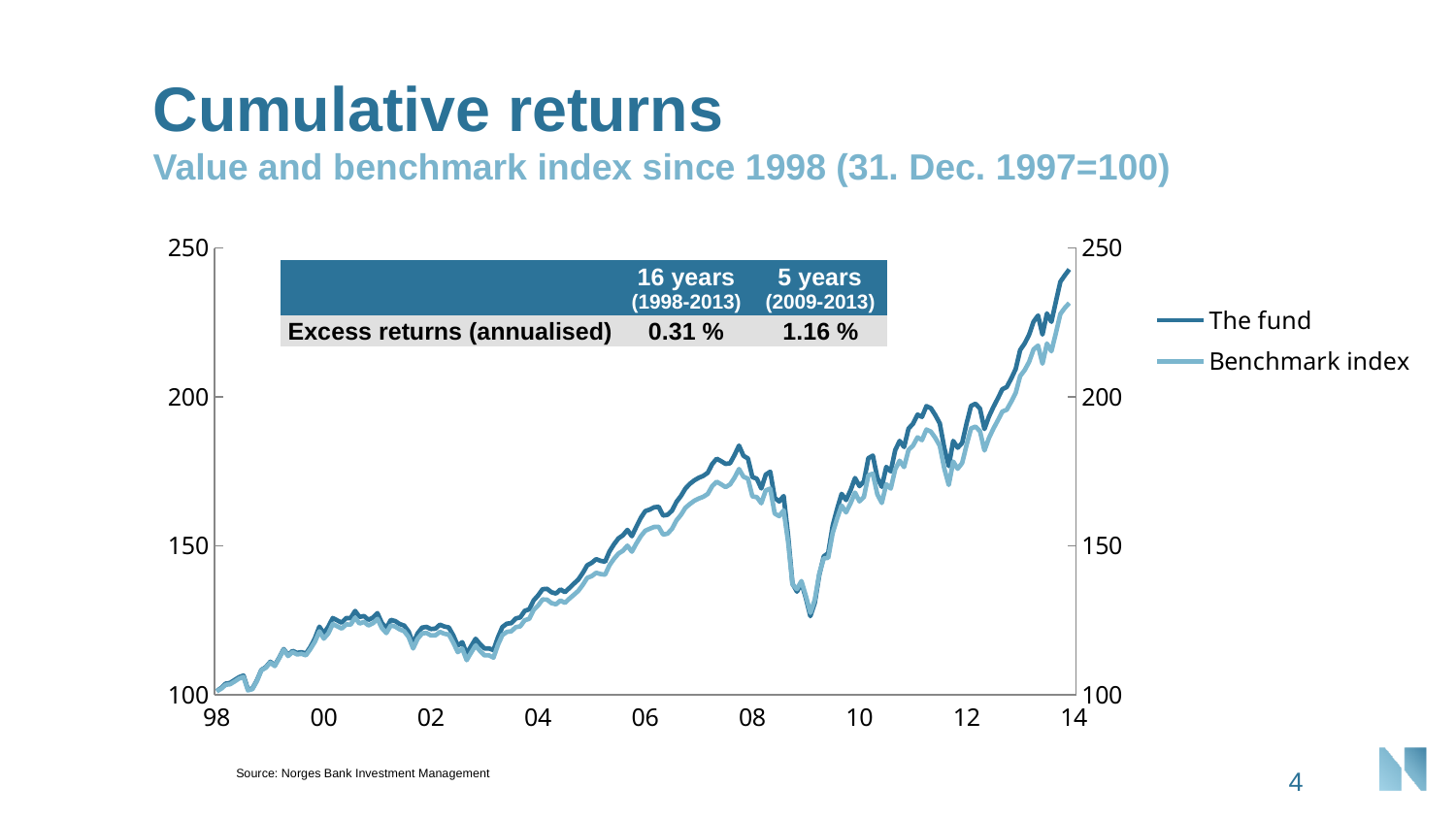
According to the subtitle, what base value is the index set to on 31 Dec. 1997? 100 What kind of chart is shown on the slide? line chart Do the values of The fund rise or fall from 2009 to 2014? rise What is the annualised excess return over 5 years (2009-2013) shown in the table on the chart? 1.16 % Is the value of The fund at its 2007 peak greater or less than 200? less Is the value of The fund at its low point in early 2009 greater or less than 150? less Is the value of The fund at the end of 2013 greater or less than 200? greater At the end of 2013, which series is higher, The fund or the Benchmark index? The fund What are the two series named in the legend? The fund and Benchmark index How many series does the legend list? 2 What is the annualised excess return over 16 years (1998-2013) shown in the table on the chart? 0.31 %